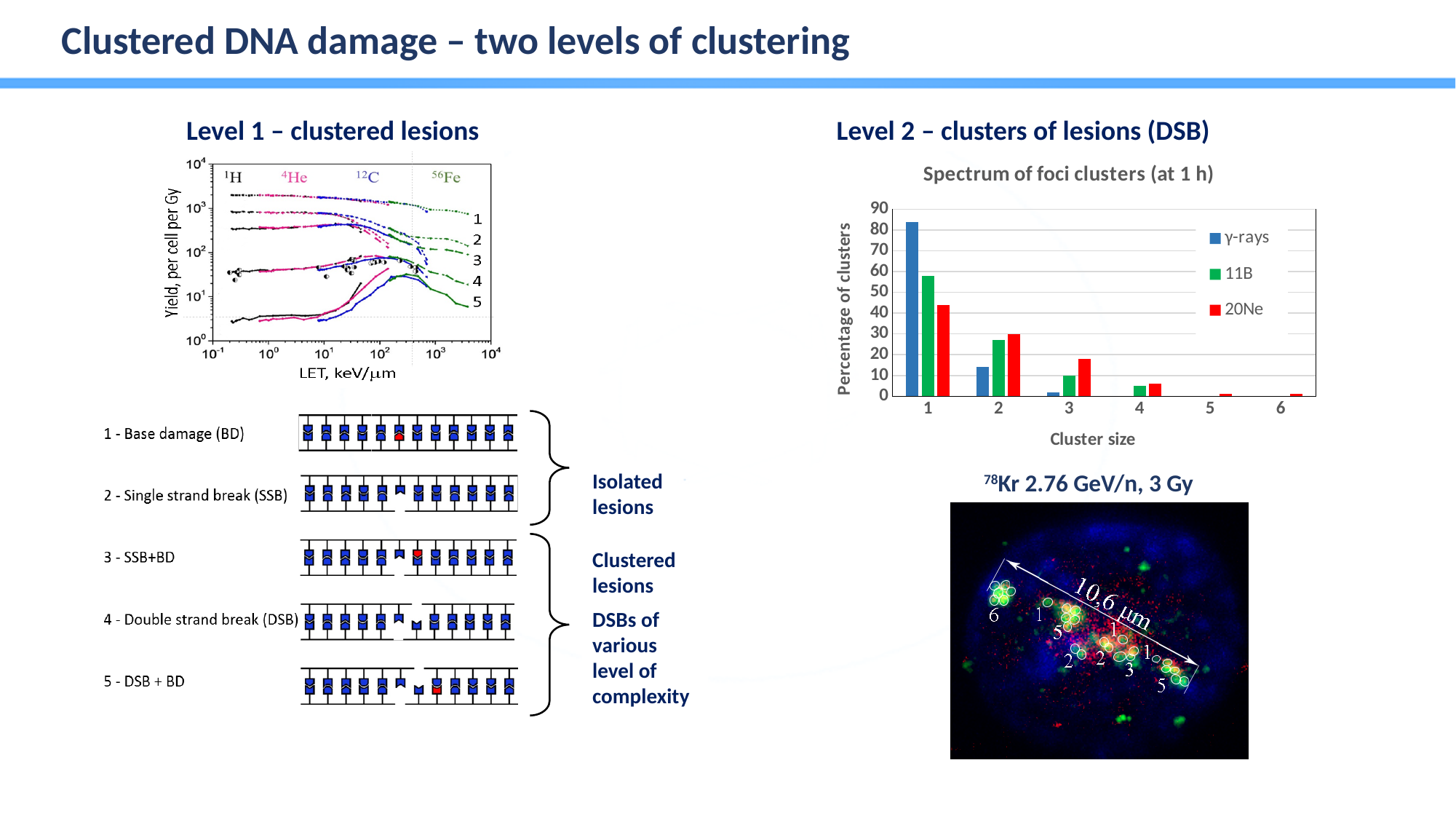
How many series does the legend of the "Spectrum of foci clusters (at 1 h)" chart list? 3 In the "Spectrum of foci clusters (at 1 h)" chart, at cluster size 3, which is larger: 11B or 20Ne? 20Ne In the "Spectrum of foci clusters (at 1 h)" chart, which series has the highest value at cluster size 1? γ-rays In the "Spectrum of foci clusters (at 1 h)" chart, is the value for γ-rays at cluster size 1 greater or less than 80? greater How many cluster size categories are shown on the x axis of the "Spectrum of foci clusters (at 1 h)" chart? 6 How many numbered curves are labelled on the right side of the line chart under "Level 1 – clustered lesions"? 5 What kind of chart is the "Spectrum of foci clusters (at 1 h)" chart? bar chart What is the x-axis label of the line chart under "Level 1 – clustered lesions"? LET, keV/μm In the "Spectrum of foci clusters (at 1 h)" chart, do the γ-rays values rise or fall as cluster size increases? fall What are the legend entries of the "Spectrum of foci clusters (at 1 h)" chart? γ-rays, 11B, 20Ne In the "Spectrum of foci clusters (at 1 h)" chart, is the value for 20Ne at cluster size 1 greater or less than 50? less In the "Spectrum of foci clusters (at 1 h)" chart, is the value for 11B at cluster size 2 greater or less than 20? greater